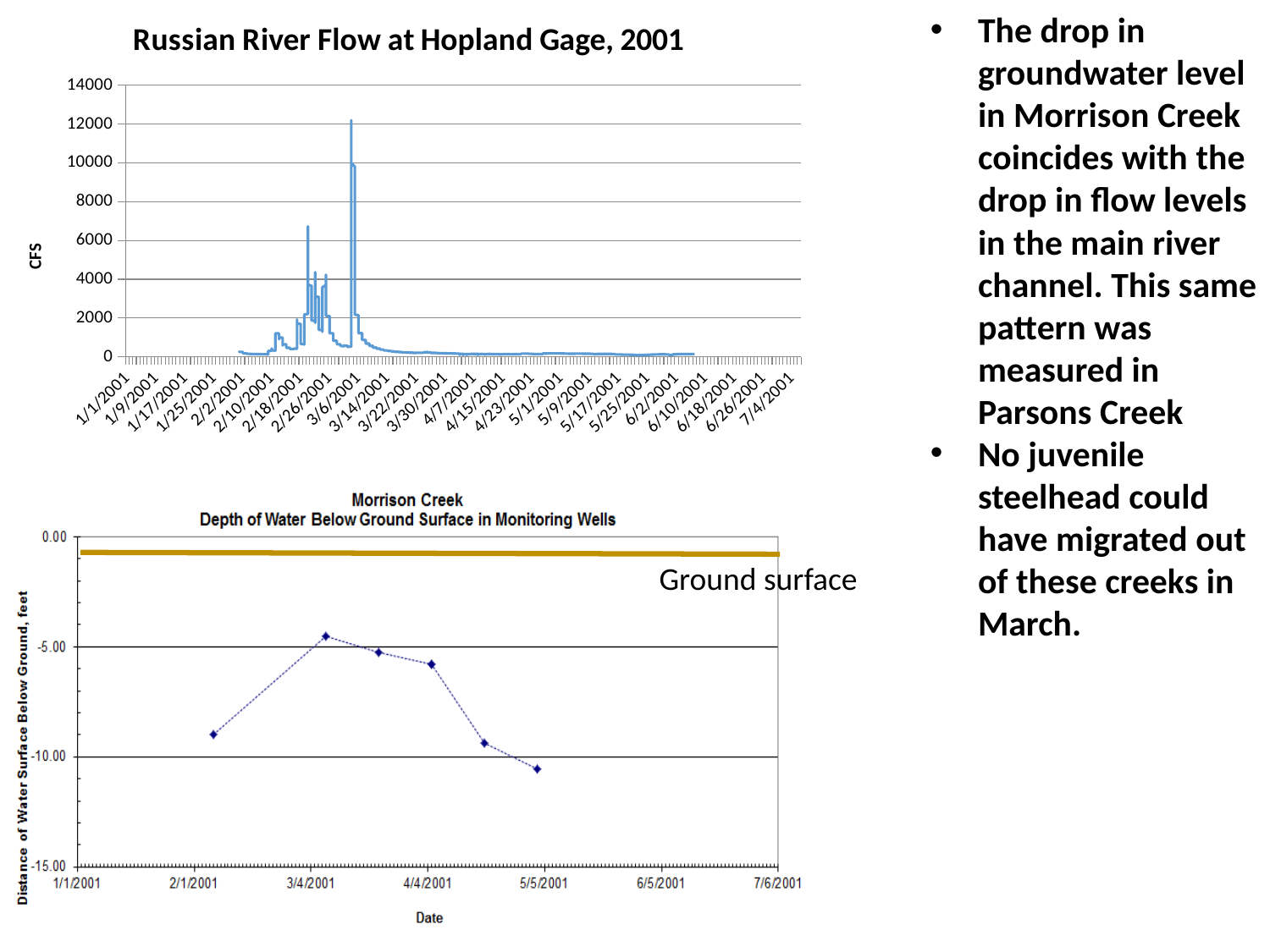
In the bottom chart, Morrison Creek Depth of Water Below Ground Surface in Monitoring Wells, do the values rise or fall from the point just after 3/4/2001 to the point near 5/5/2001? fall In the top chart, Russian River Flow at Hopland Gage, 2001, is the flow on 5/1/2001 greater or less than 2000? less What kind of chart is the top chart, Russian River Flow at Hopland Gage, 2001? line chart In the bottom chart, Morrison Creek Depth of Water Below Ground Surface in Monitoring Wells, is the value of the last data point (near 5/5/2001) greater or less than -10.00? less In the bottom chart, Morrison Creek Depth of Water Below Ground Surface in Monitoring Wells, which is larger: the value of the first data point (near 2/1/2001) or the value of the point just after 3/4/2001? the point just after 3/4/2001 In the top chart, Russian River Flow at Hopland Gage, 2001, is the highest peak of the flow greater or less than 10000? greater What is the title of the top chart? Russian River Flow at Hopland Gage, 2001 In the top chart, Russian River Flow at Hopland Gage, 2001, what is the label on the vertical axis? CFS In the top chart, Russian River Flow at Hopland Gage, 2001, does the flow rise or fall between 3/6/2001 and 4/7/2001? fall What kind of chart is the bottom chart, Morrison Creek Depth of Water Below Ground Surface in Monitoring Wells? line chart How many data points are plotted in the bottom chart, Morrison Creek Depth of Water Below Ground Surface in Monitoring Wells? 6